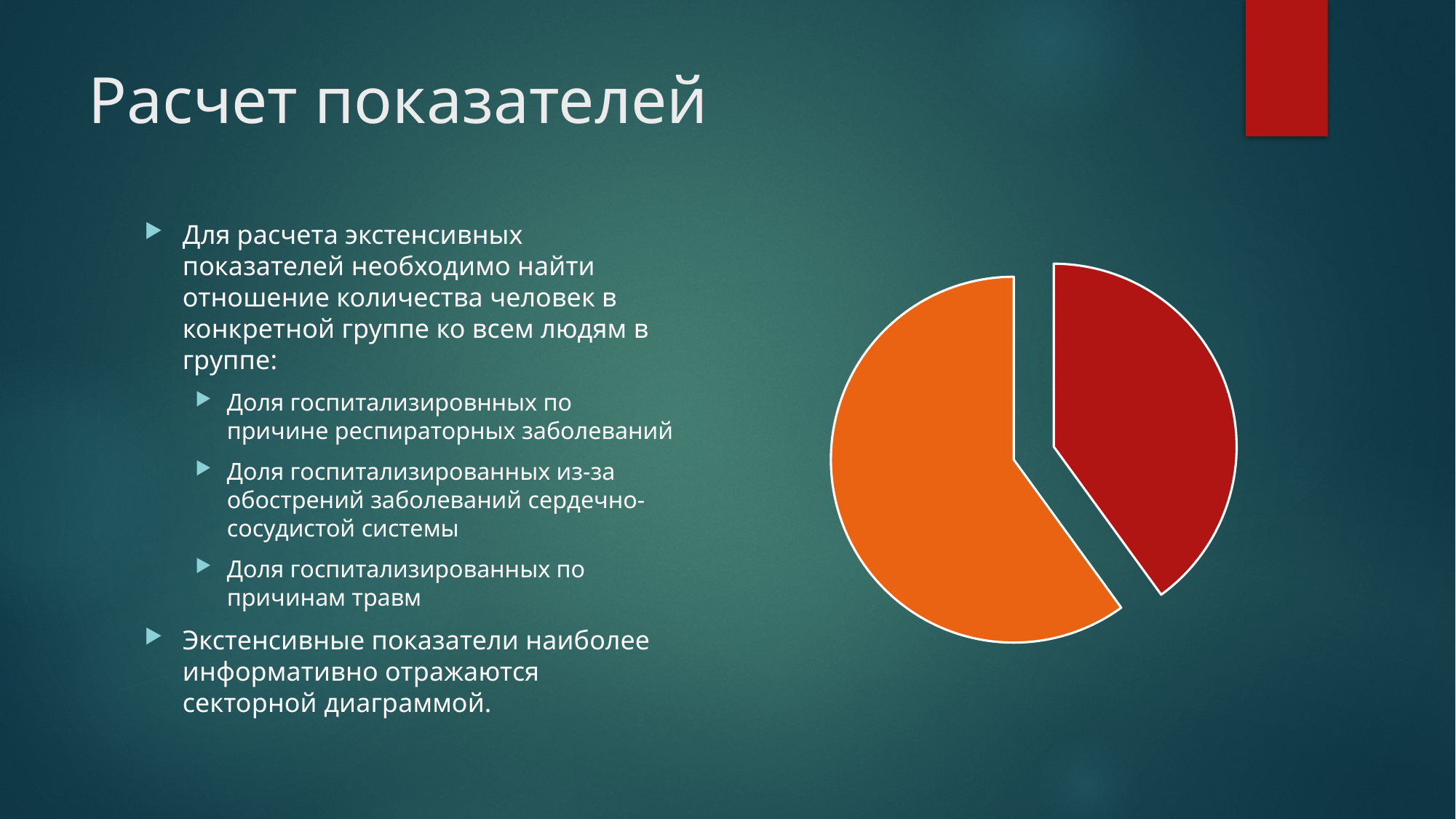
Which slice of the pie chart is pulled out (exploded) from the rest of the pie? the red slice Which colour slice takes up the largest share of the pie chart? orange Does the pie chart display a legend? No Which slice of the pie chart is larger, the orange one or the red one? the orange one Which colour slice takes up the smallest share of the pie chart? red How many slices does the pie chart have? 2 What kind of chart is shown on the slide? pie chart